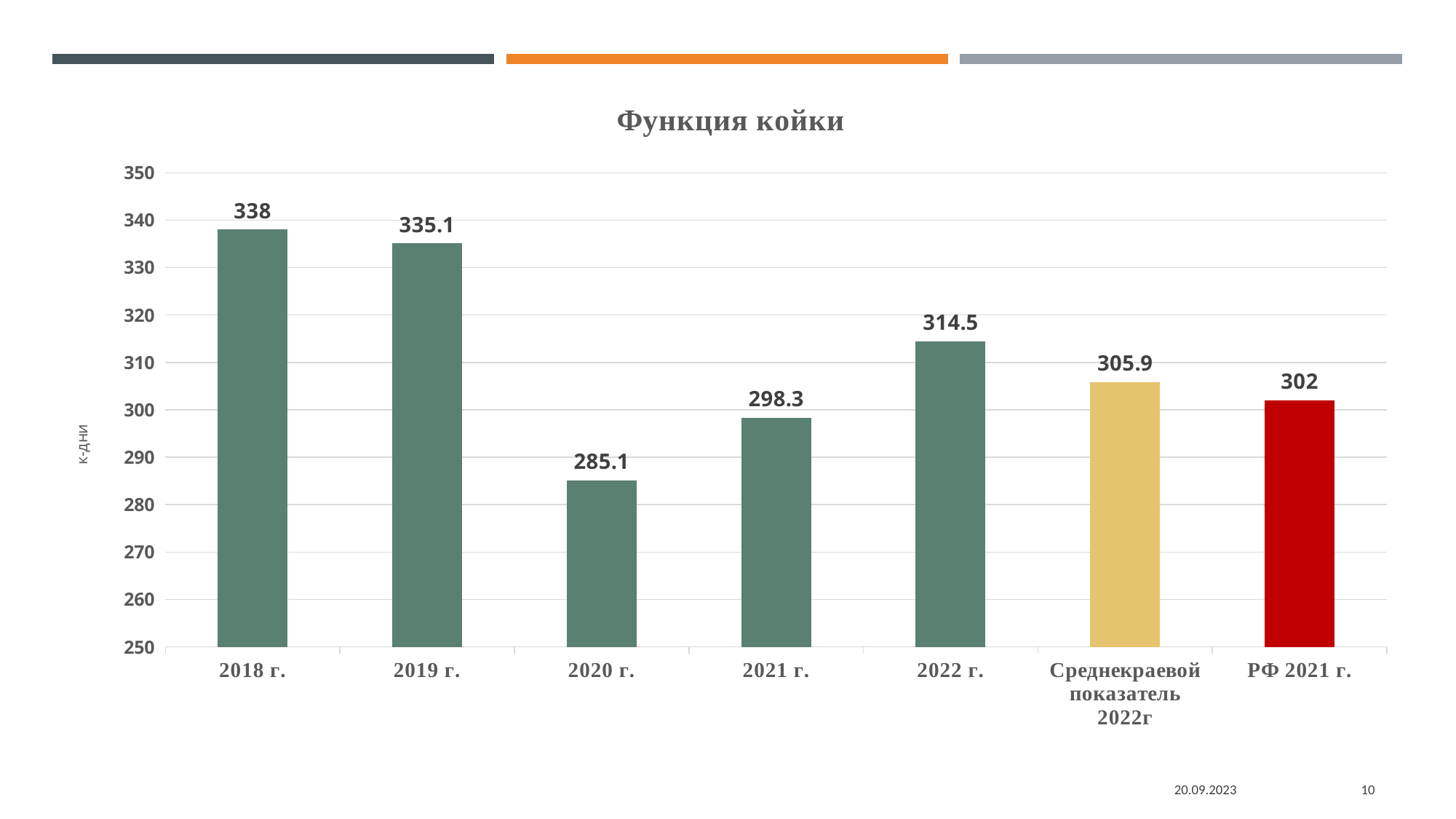
What is the value for 2018 г.? 338 Which category has the lowest value? 2020 г. Do the values rise or fall from 2020 г. to 2022 г.? rise Which category has the highest value? 2018 г. What is the value for 2020 г.? 285.1 What is the value for РФ 2021 г.? 302 What is the title of the chart? Функция койки How many bars are shown in the chart? 7 What kind of chart is shown on the slide? bar chart What is the value for Среднекраевой показатель 2022г? 305.9 Which is larger, the value for 2022 г. or the value for Среднекраевой показатель 2022г? 2022 г. What is the difference between the values for 2022 г. and 2021 г.? 16.2